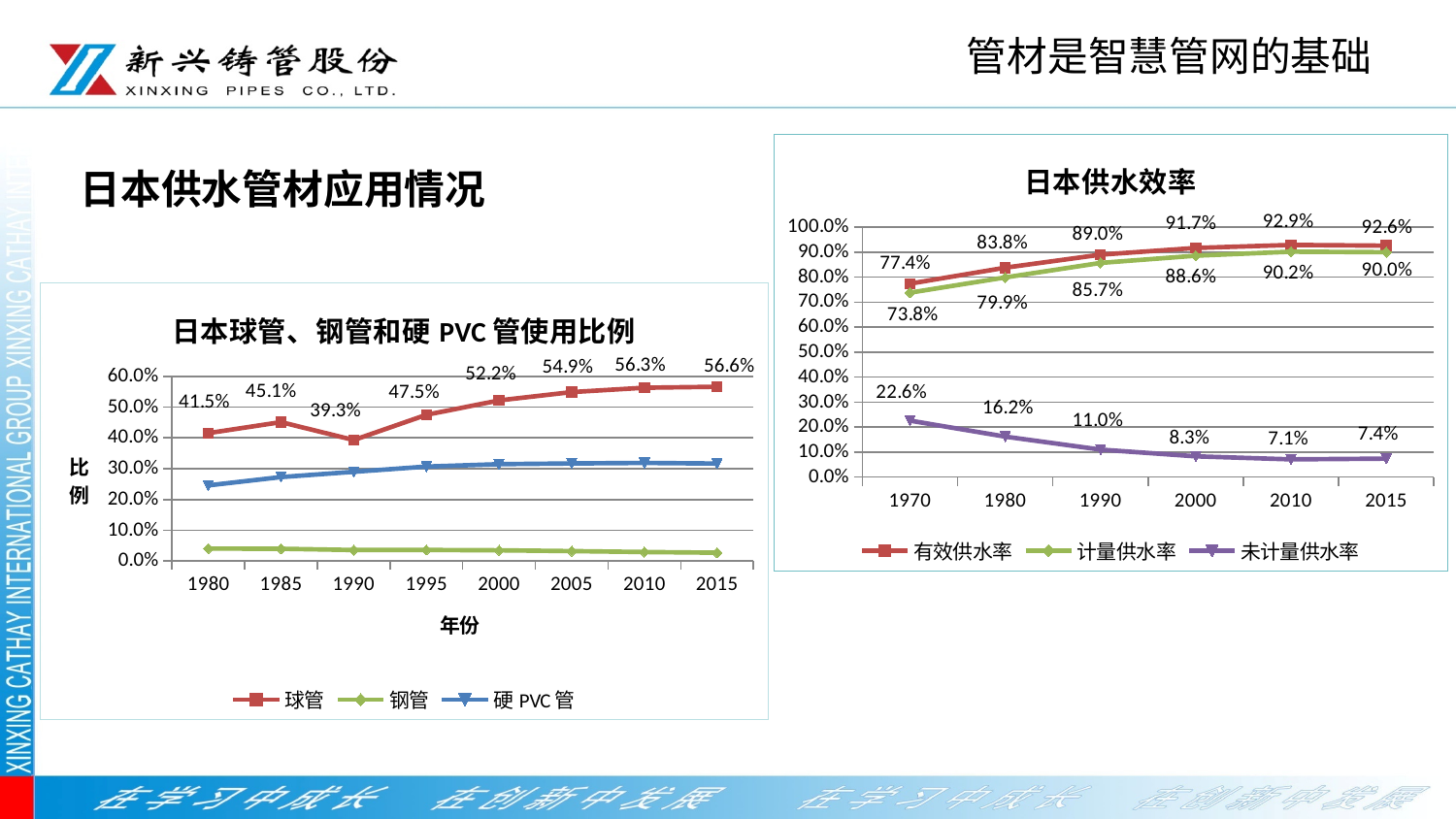
In the chart titled 日本供水效率, in which year is 有效供水率 highest? 2010 In the chart titled 日本球管、钢管和硬 PVC 管使用比例, how many series does the legend list? 3 In the chart titled 日本球管、钢管和硬 PVC 管使用比例, what is the value for 球管 in 1990? 39.3% What kind of chart is 日本供水效率? line chart In the chart titled 日本球管、钢管和硬 PVC 管使用比例, what is the difference between the 球管 values in 2015 and 1980? 15.1% In the chart titled 日本球管、钢管和硬 PVC 管使用比例, in which year is the 球管 value highest? 2015 In the chart titled 日本供水效率, what is the value for 计量供水率 in 2000? 88.6% In the chart titled 日本球管、钢管和硬 PVC 管使用比例, how many years are shown on the x axis? 8 In the chart titled 日本供水效率, does 未计量供水率 generally rise or fall from 1970 to 2015? fall In the chart titled 日本球管、钢管和硬 PVC 管使用比例, which series has the lowest values across all years? 钢管 In the chart titled 日本供水效率, what is the value for 未计量供水率 in 1970? 22.6% In the chart titled 日本球管、钢管和硬 PVC 管使用比例, is the value for 硬 PVC 管 in 1980 greater or less than 30.0%? less